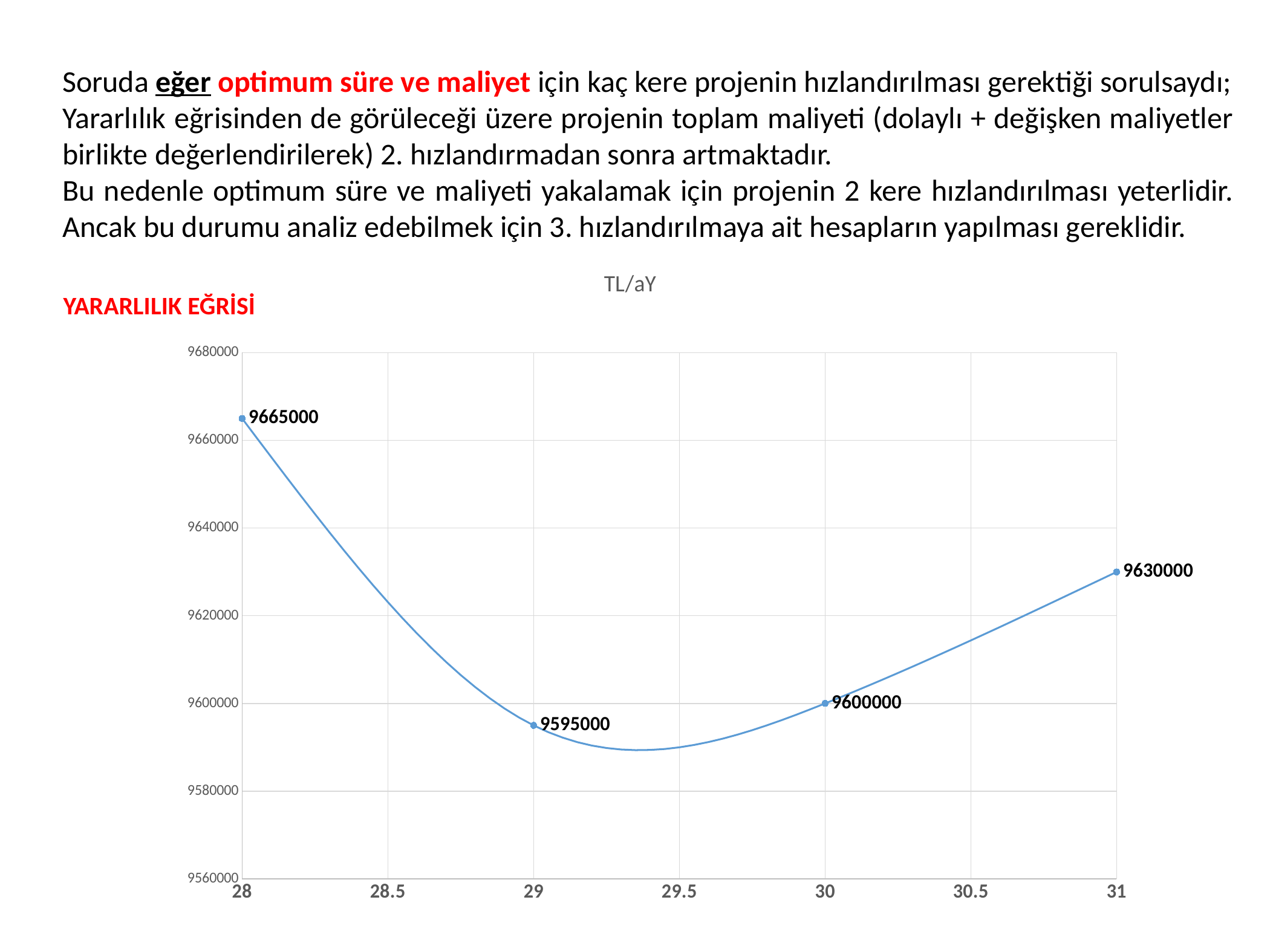
What is the difference between the values at x = 31 and x = 30? 30000 What is the value at x = 29 on the chart? 9595000 What is the difference between the values at x = 28 and x = 29? 70000 What kind of chart is shown on the slide? line chart Which is larger, the value at x = 30 or the value at x = 31? x = 31 At which x value is the plotted value highest? 28 How many data points are plotted on the chart? 4 What is the value at x = 28 on the chart? 9665000 What is the title of the chart? TL/aY What is the value at x = 31 on the chart? 9630000 At which x value is the plotted value lowest? 29 What is the value at x = 30 on the chart? 9600000